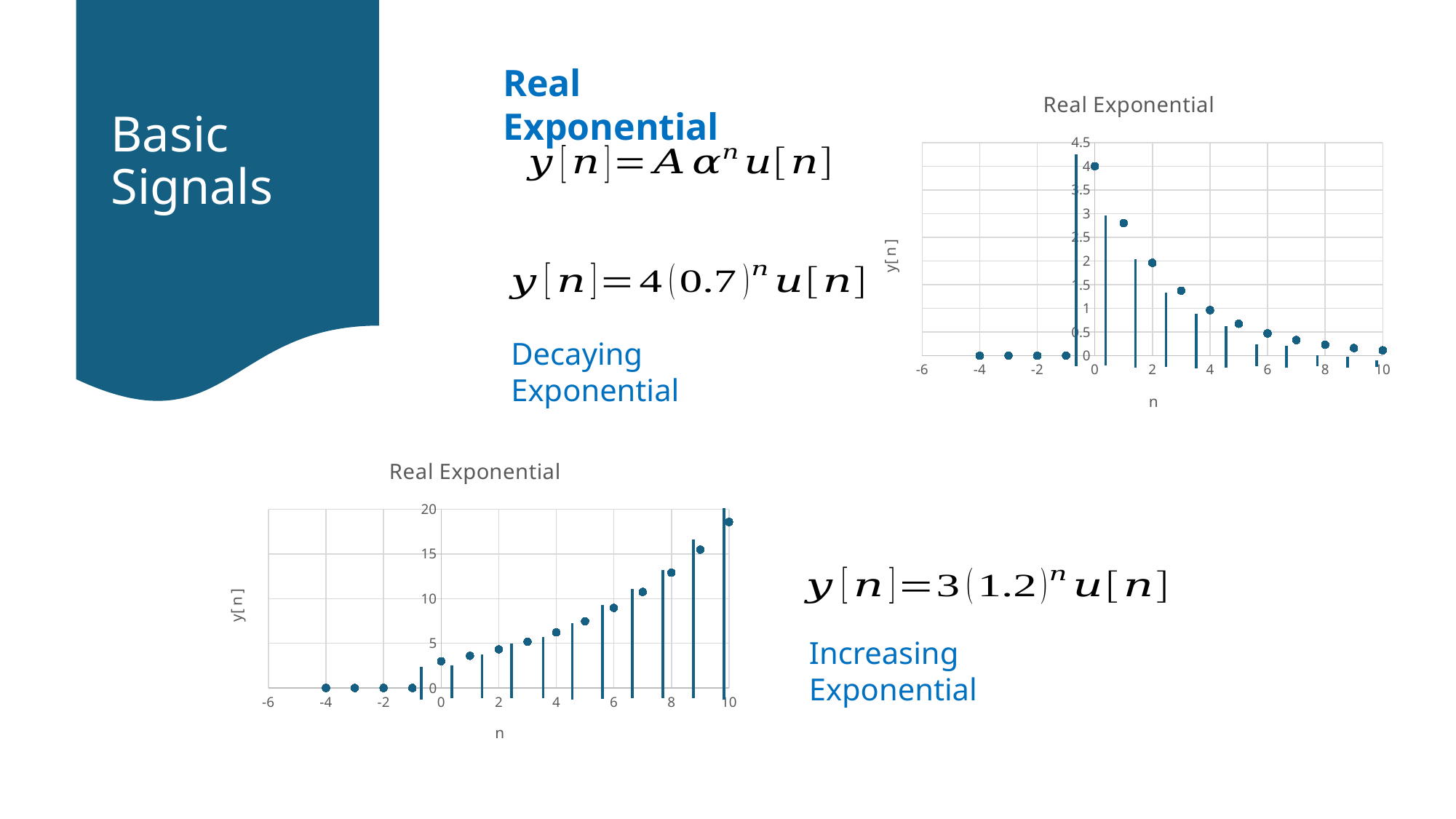
In the top-right chart, what is the value of y[n] at n = -2? 0 What is the y-axis label of the bottom-left chart? y[n] In the bottom-left chart, is the value at n = 10 greater or less than 15? greater In the bottom-left chart, do the values rise or fall as n increases from 0 to 10? rise In the top-right chart, is the value at n = 10 greater or less than 0.5? less In the top-right chart, is the value at n = 1 greater or less than 2? greater In the bottom-left chart, at which n is y[n] highest? n = 10 In the top-right chart, what is the value of y[n] at n = 0? 4 In the top-right chart, do the values rise or fall as n increases from 0 to 10? fall In the top-right chart, at which n is y[n] highest? n = 0 In the top-right chart, which is larger, the value at n = 2 or the value at n = 4? n = 2